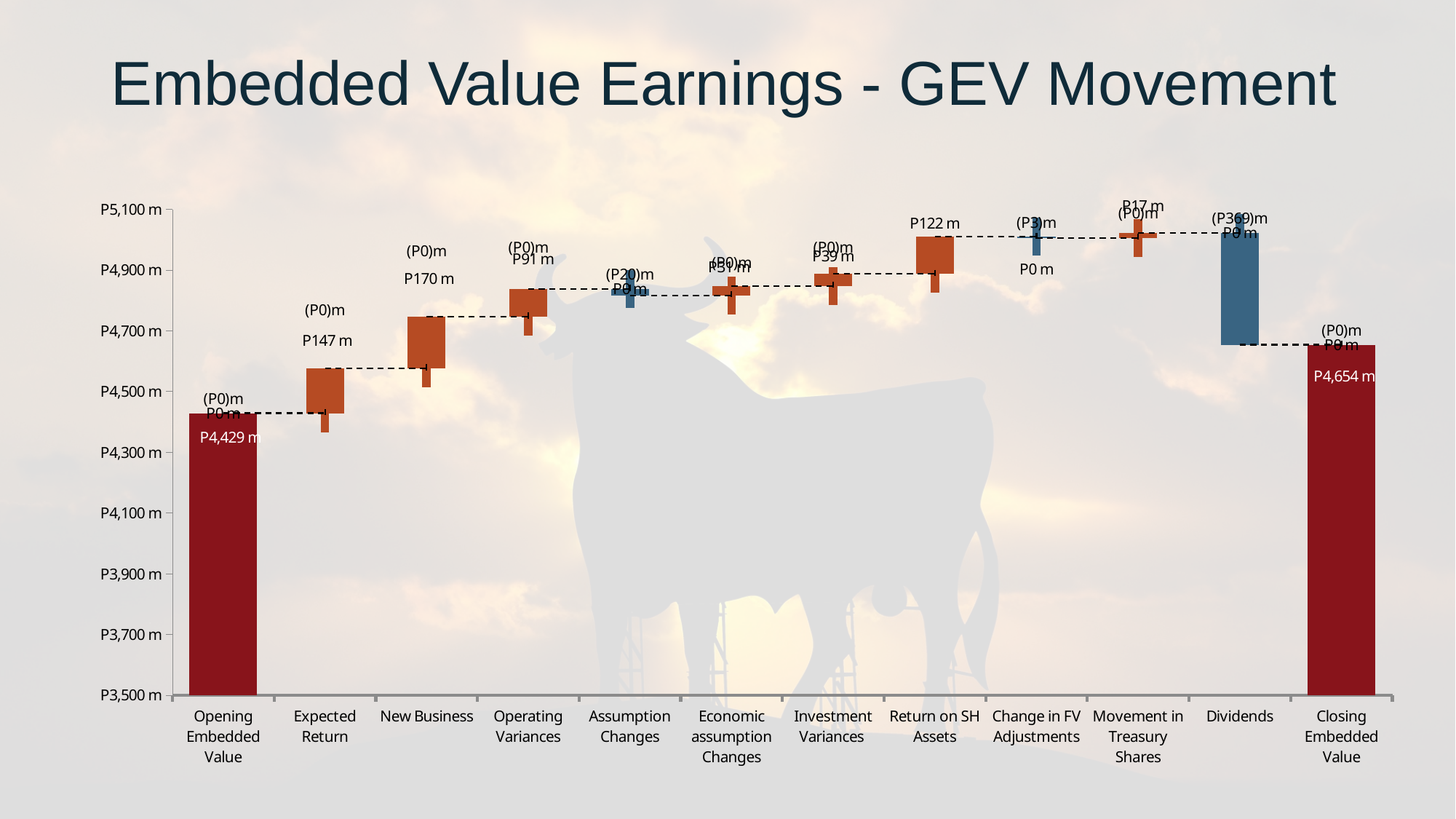
Which movement category has the largest positive value? New Business What is the value of the Closing Embedded Value bar? P4,654 m Is the Opening Embedded Value greater or less than P4,500 m? less What is the value shown for Return on SH Assets? P122 m What is the title of the chart? Embedded Value Earnings - GEV Movement By how much does the Closing Embedded Value exceed the Opening Embedded Value? P225 m What is the value shown for Assumption Changes? (P20)m What is the value shown for Dividends? (P369)m What is the value of the Opening Embedded Value bar? P4,429 m How many categories are shown on the x axis? 12 What is the value shown for New Business? P170 m Which is larger, the value for Expected Return or the value for Return on SH Assets? Expected Return